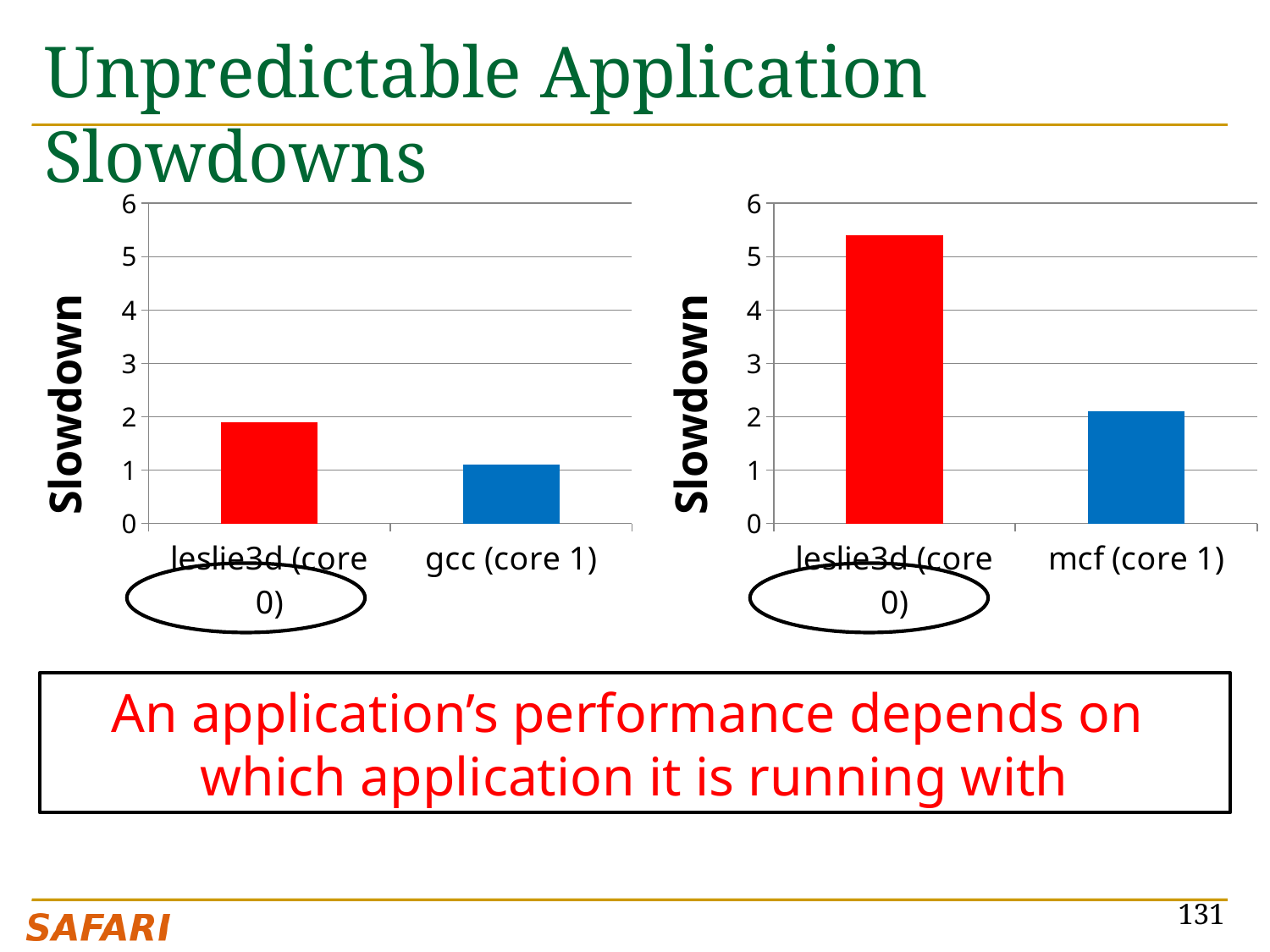
In the right chart, which category has the highest slowdown? leslie3d (core 0) How many categories are shown in the left chart? 2 What is the y-axis label of the left chart? Slowdown In the left chart, is the slowdown for gcc (core 1) greater or less than 2? less In the right chart, is the slowdown for leslie3d (core 0) larger or smaller than the slowdown for mcf (core 1)? larger In the left chart, which category has the lower slowdown? gcc (core 1) What kind of chart is the right chart? bar chart In the left chart, which category has the higher slowdown? leslie3d (core 0) In the right chart, which category has the lowest slowdown? mcf (core 1) In the right chart, is the slowdown for leslie3d (core 0) greater or less than 5? greater